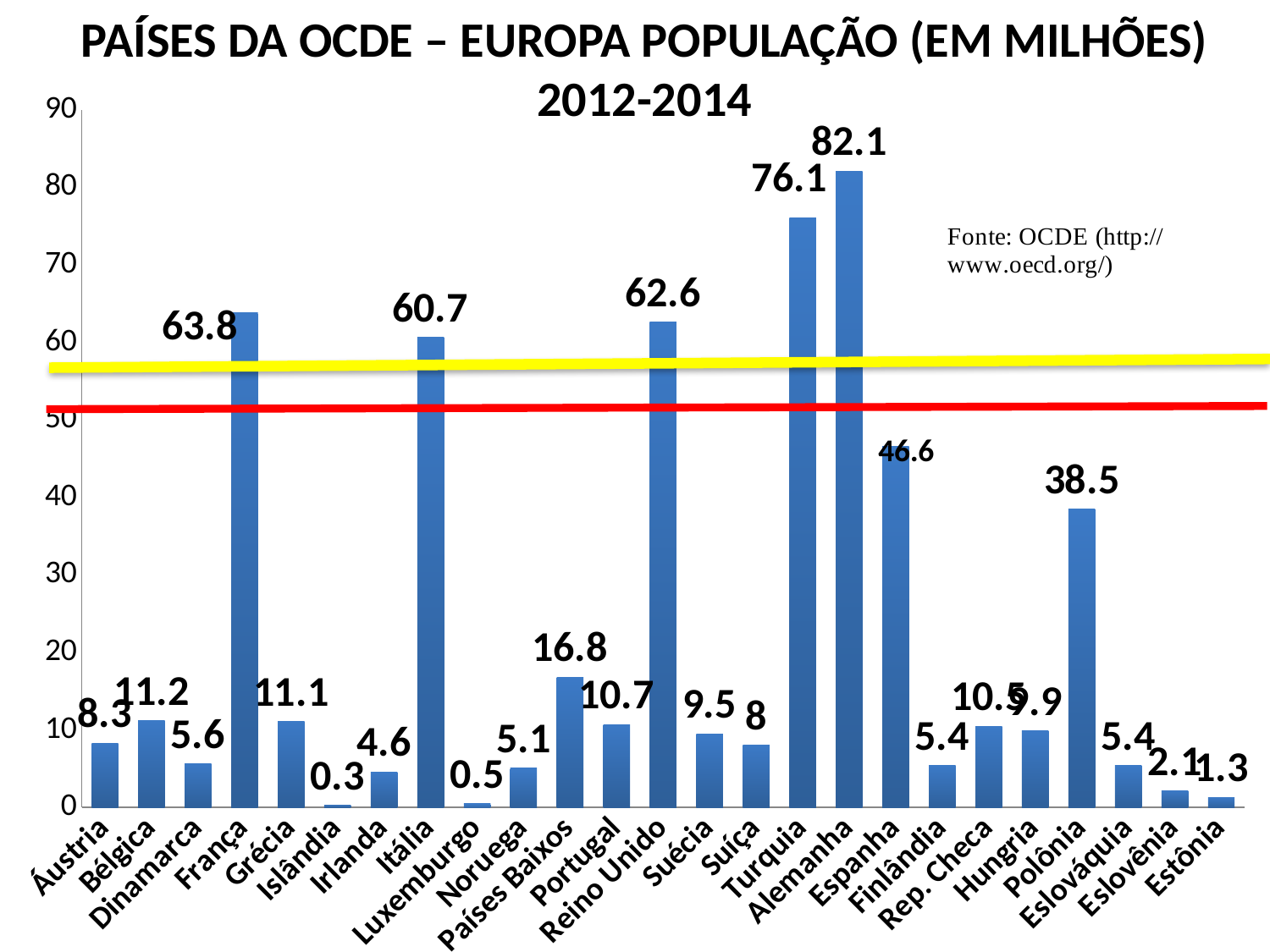
What is the population value shown for Polônia? 38.5 What is the population value shown for França? 63.8 Which has a larger value, Espanha or Polônia? Espanha What kind of chart is shown on the slide? Bar chart Which country has the highest population in the chart? Alemanha Which has a larger value, Itália or Reino Unido? Reino Unido What is the difference between the values for França and Reino Unido? 1.2 How many countries are shown on the x axis of the chart? 25 Which country has the lowest population in the chart? Islândia What is the difference between the values for Alemanha and Turquia? 6 What is the population value shown for Países Baixos? 16.8 What is the title of the chart? PAÍSES DA OCDE – EUROPA POPULAÇÃO (EM MILHÕES) 2012-2014